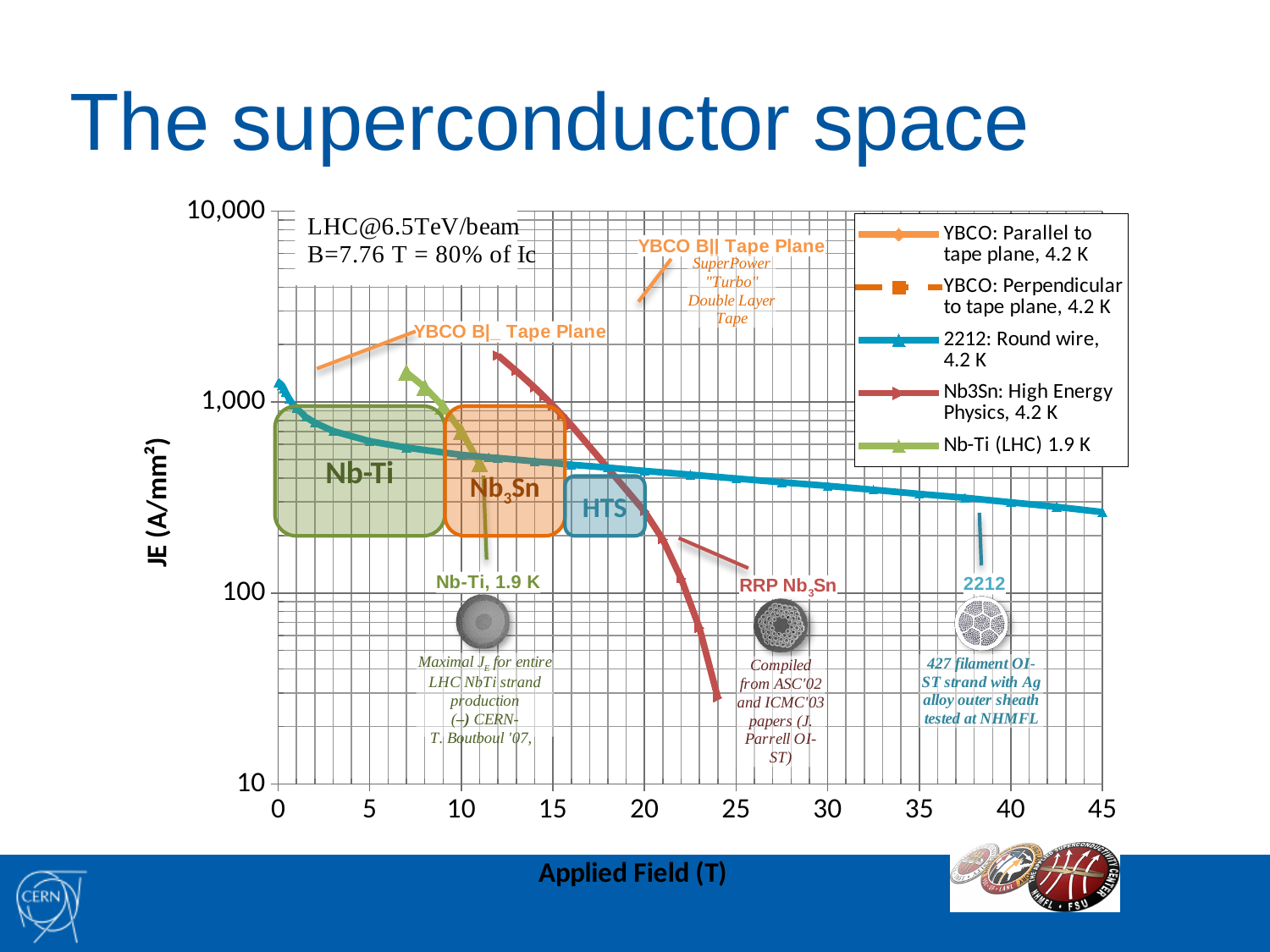
What is the label of the y axis of the chart? JE (A/mm²) How many series does the chart legend list? 5 Is the JE value of the '2212: Round wire, 4.2 K' series at 45 T greater or less than 100? greater How many tick marks are labelled on the x axis of the chart? 10 Is the JE value of the '2212: Round wire, 4.2 K' series at 45 T greater or less than 1,000? less What kind of chart is shown on the slide? line chart What is the label of the x axis of the chart? Applied Field (T) Is the JE value of the 'Nb3Sn: High Energy Physics, 4.2 K' series at 24 T greater or less than 100? less Does the JE value of the '2212: Round wire, 4.2 K' series rise or fall as the applied field increases? fall At an applied field of 22 T, which series has the higher JE: '2212: Round wire, 4.2 K' or 'Nb3Sn: High Energy Physics, 4.2 K'? 2212: Round wire, 4.2 K At an applied field of 15 T, which series has the higher JE: 'Nb3Sn: High Energy Physics, 4.2 K' or '2212: Round wire, 4.2 K'? Nb3Sn: High Energy Physics, 4.2 K Which series reaches the highest JE value on the chart? YBCO: Parallel to tape plane, 4.2 K